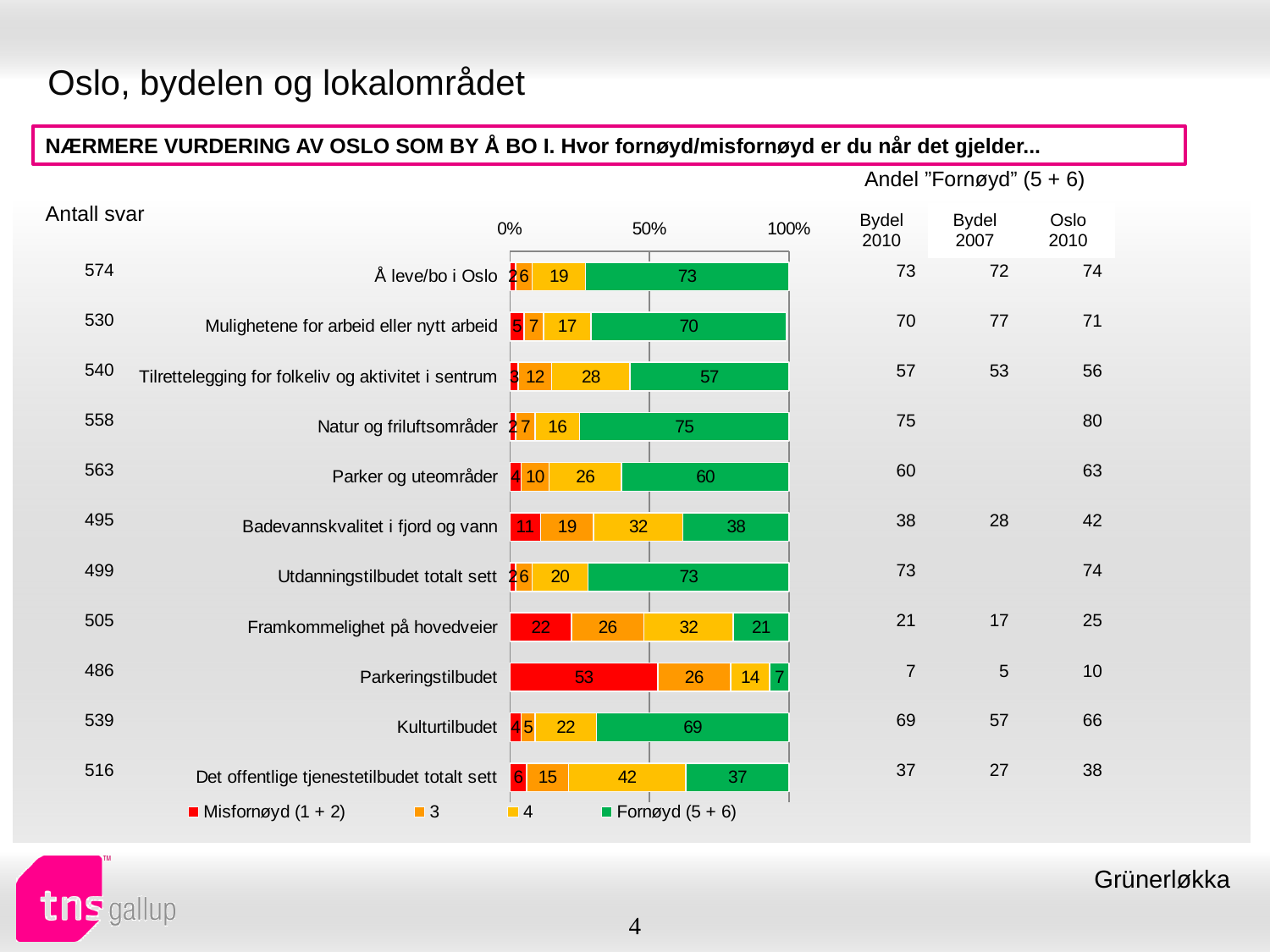
How many series does the legend list? 4 Which is larger: the Fornøyd (5 + 6) value for Parker og uteområder or for Tilrettelegging for folkeliv og aktivitet i sentrum? Parker og uteområder What is the value of series 4 for Det offentlige tjenestetilbudet totalt sett? 42 What is the Fornøyd (5 + 6) value for Parkeringstilbudet? 7 What kind of chart is shown on the slide? Stacked bar chart Which series is shown in green in the chart? Fornøyd (5 + 6) What is the difference between the Fornøyd (5 + 6) values for Kulturtilbudet and Framkommelighet på hovedveier? 48 Which category has the highest Fornøyd (5 + 6) value? Natur og friluftsområder What is the Fornøyd (5 + 6) value for Badevannskvalitet i fjord og vann? 38 What is the Misfornøyd (1 + 2) value for Parkeringstilbudet? 53 Which category has the lowest Fornøyd (5 + 6) value? Parkeringstilbudet How many categories are shown in the chart? 11